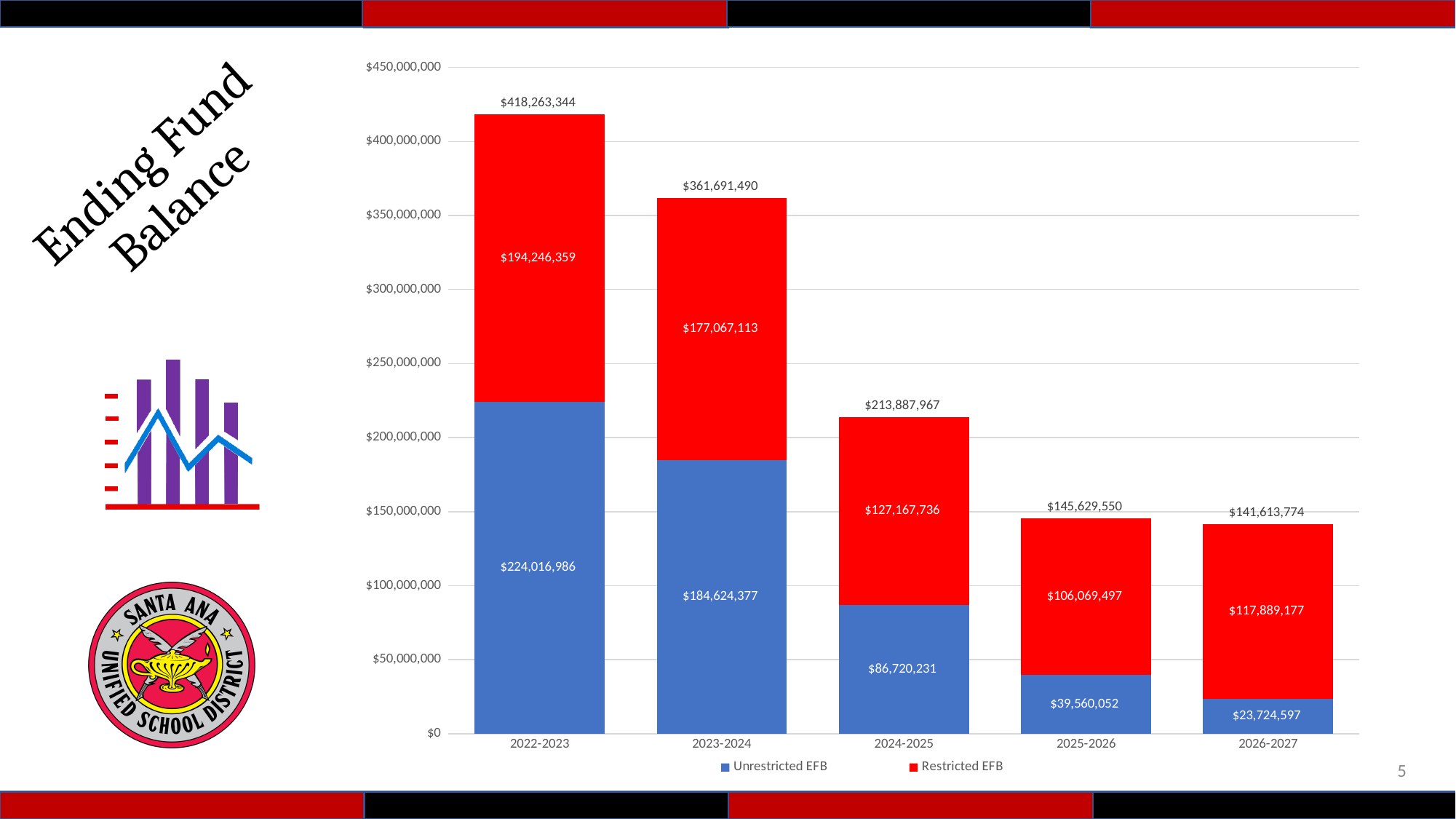
What is the difference between the Restricted EFB values for 2022-2023 and 2023-2024? $17,179,246 Which year has the highest total ending fund balance? 2022-2023 How many series does the legend list? 2 Do the total ending fund balances rise or fall from 2022-2023 to 2026-2027? Fall What is the Restricted EFB value for 2024-2025? $127,167,736 What is the difference between the Unrestricted EFB values for 2025-2026 and 2026-2027? $15,835,455 Which year has the lowest Unrestricted EFB value? 2026-2027 What is the total ending fund balance shown for 2025-2026? $145,629,550 How many fiscal years are shown on the x axis? 5 What kind of chart is shown on the slide? Stacked bar chart In 2026-2027, which is larger: Unrestricted EFB or Restricted EFB? Restricted EFB What is the Unrestricted EFB value for 2022-2023? $224,016,986